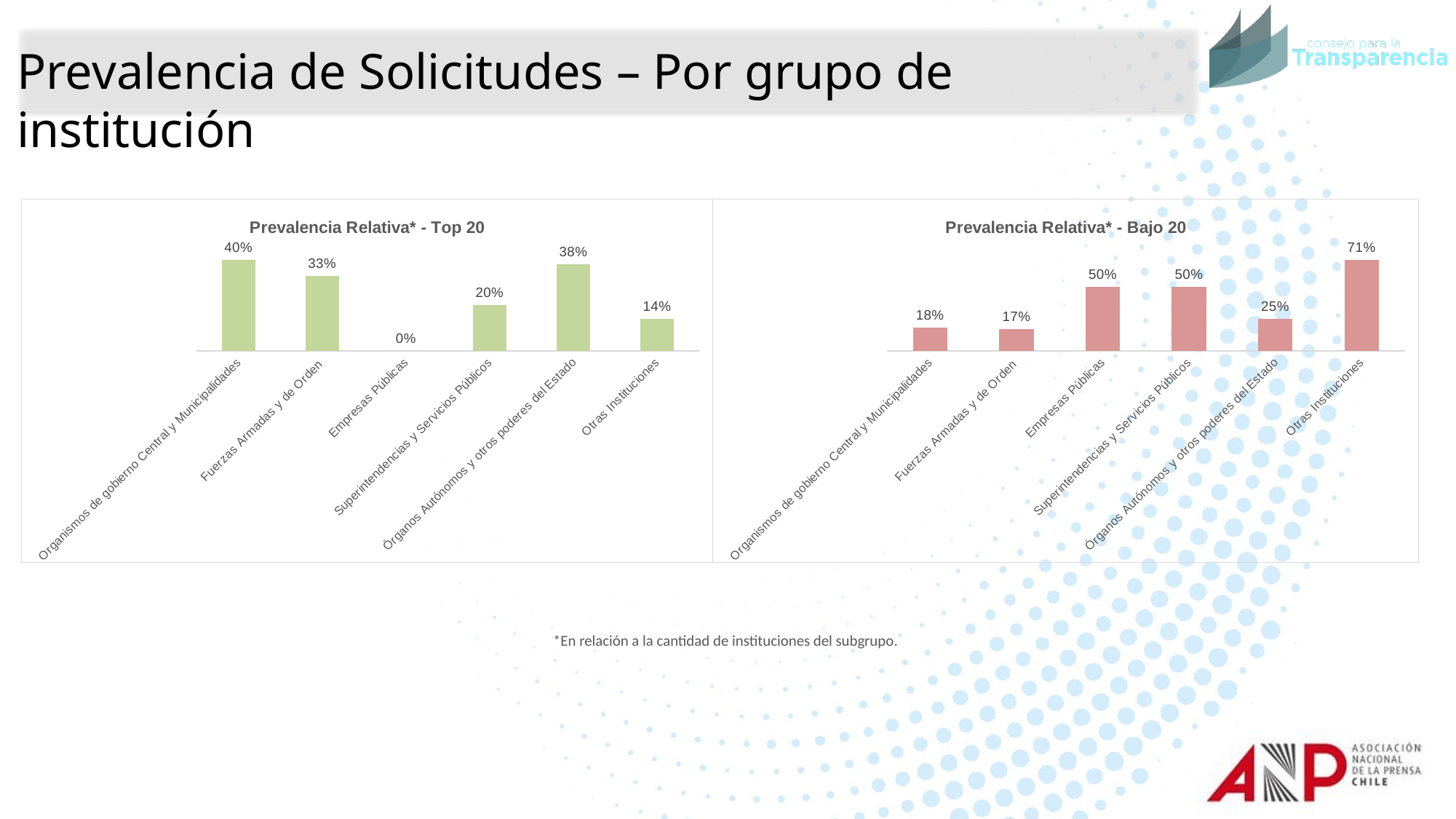
In the 'Prevalencia Relativa* - Top 20' chart, what is the difference between Organismos de gobierno Central y Municipalidades and Otras Instituciones? 26% How many categories are shown in the 'Prevalencia Relativa* - Bajo 20' chart? 6 What kind of chart is 'Prevalencia Relativa* - Top 20'? Bar chart In the 'Prevalencia Relativa* - Bajo 20' chart, which category has the lowest value? Fuerzas Armadas y de Orden In the 'Prevalencia Relativa* - Top 20' chart, which category has the lowest value? Empresas Públicas What colour are the bars in the 'Prevalencia Relativa* - Bajo 20' chart? Red In the 'Prevalencia Relativa* - Bajo 20' chart, what is the difference between Otras Instituciones and Órganos Autónomos y otros poderes del Estado? 46% In the 'Prevalencia Relativa* - Top 20' chart, which category has the highest value? Organismos de gobierno Central y Municipalidades In the 'Prevalencia Relativa* - Top 20' chart, what is the value for Fuerzas Armadas y de Orden? 33% In the 'Prevalencia Relativa* - Bajo 20' chart, what is the value for Otras Instituciones? 71% In the 'Prevalencia Relativa* - Top 20' chart, which is larger: Superintendencias y Servicios Públicos or Órganos Autónomos y otros poderes del Estado? Órganos Autónomos y otros poderes del Estado In the 'Prevalencia Relativa* - Bajo 20' chart, which category has the highest value? Otras Instituciones